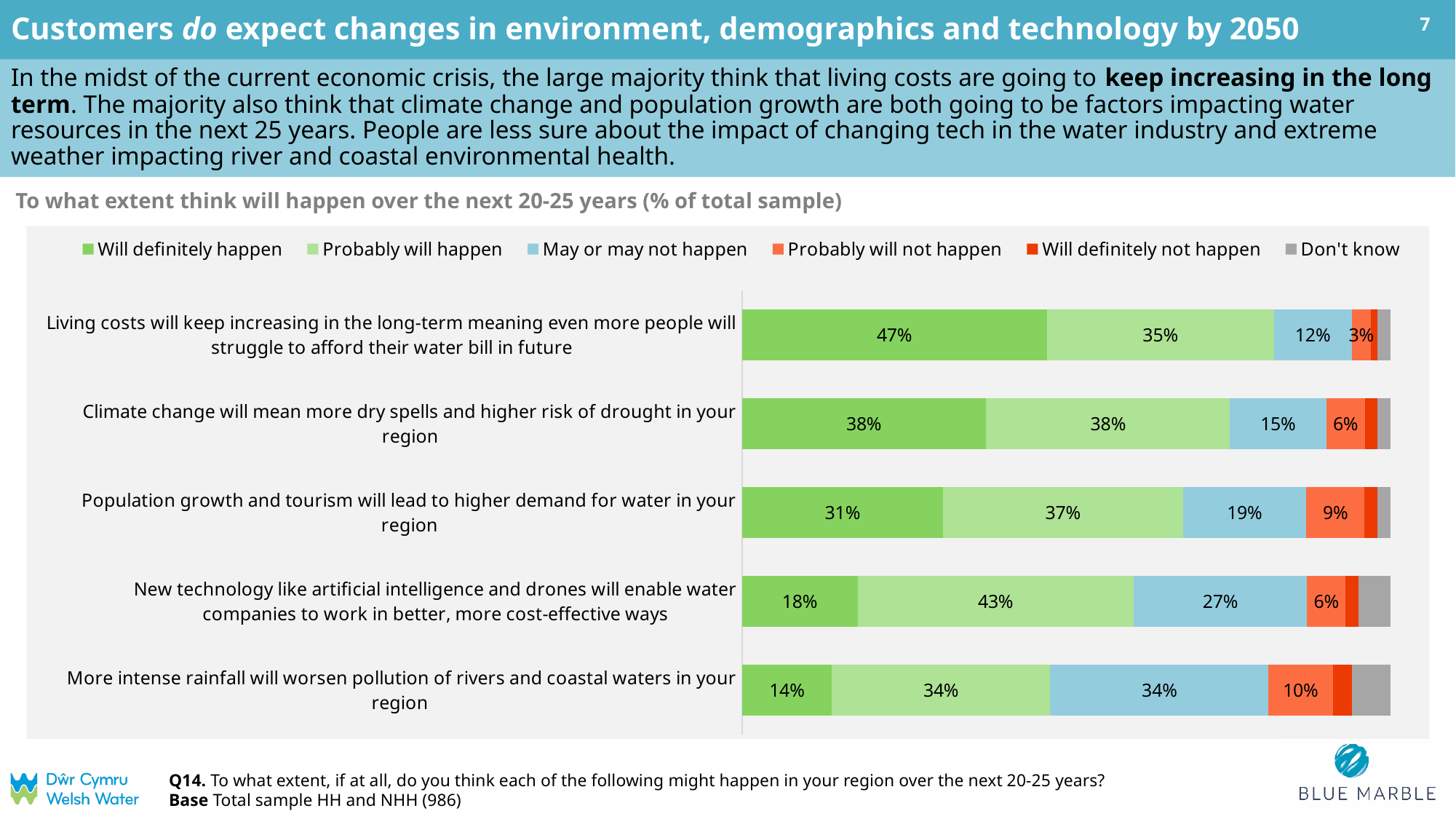
Which is larger: the 'May or may not happen' value for new technology or for climate change? New technology (27%) What percentage say living costs will keep increasing in the long-term 'Will definitely happen'? 47% What is the title of the chart? To what extent think will happen over the next 20-25 years (% of total sample) Which statement has the lowest 'Will definitely happen' percentage? More intense rainfall will worsen pollution of rivers and coastal waters in your region What is the 'May or may not happen' value for more intense rainfall worsening pollution of rivers and coastal waters? 34% Which statement has the highest 'Will definitely happen' percentage? Living costs will keep increasing in the long-term meaning even more people will struggle to afford their water bill in future What is the 'Probably will not happen' value for population growth and tourism leading to higher demand for water? 9% How many series does the legend list? 6 What kind of chart is shown on the slide? Stacked bar chart How many statements (categories) are plotted in the chart? 5 What percentage say new technology like AI and drones enabling water companies to work better 'Probably will happen'? 43% What is the difference between the 'Will definitely happen' values for living costs increasing (47%) and climate change meaning more dry spells (38%)? 9 percentage points